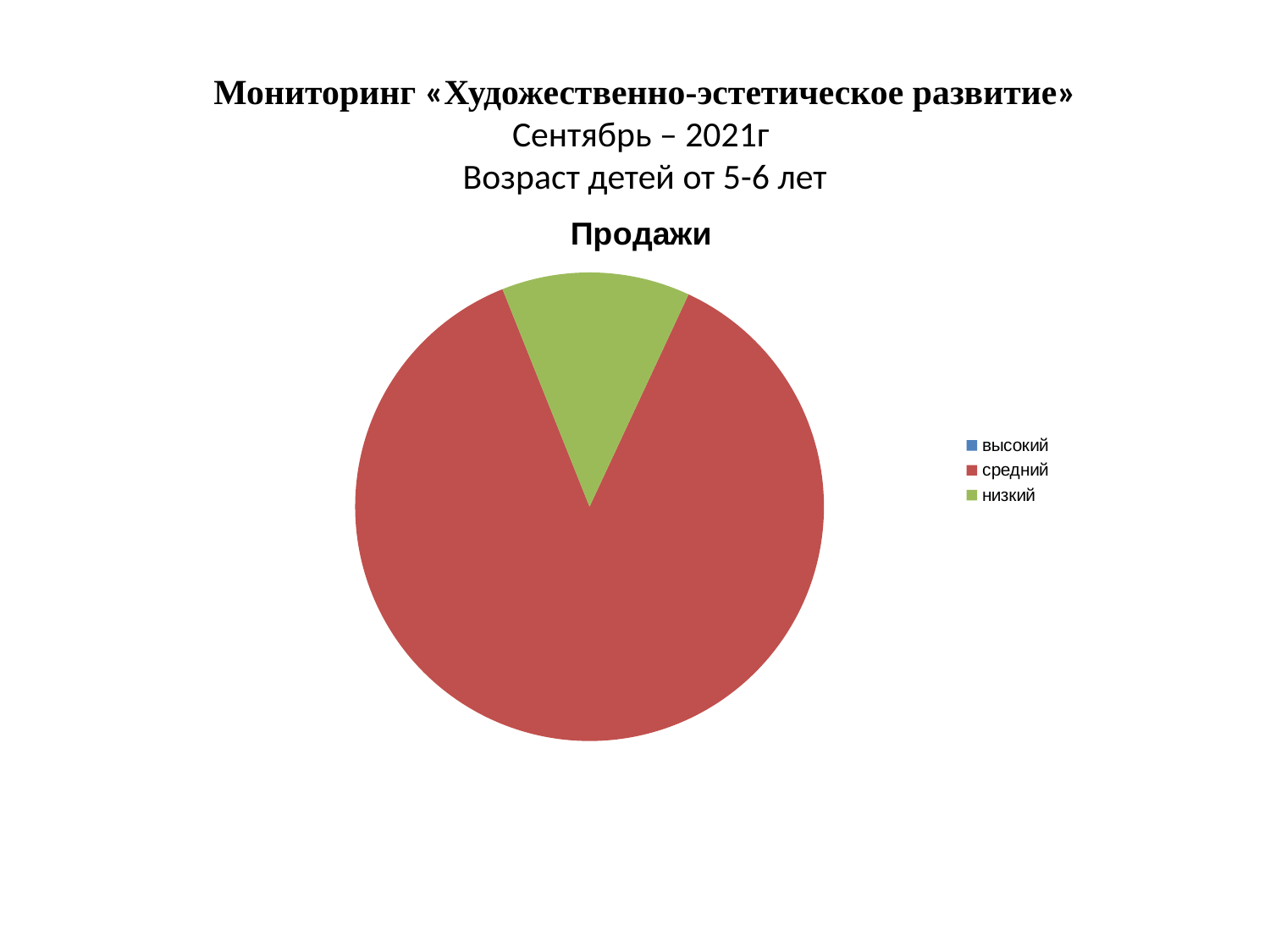
Does the slice for низкий take up more or less than a quarter of the pie? less Does the slice for средний take up more or less than half of the pie? more How many entries does the chart legend list? 3 What kind of chart is shown on the slide? pie chart What is the title of the chart? Продажи Which colour represents the category низкий in the chart? green Which slice is larger, средний or низкий? средний Which category has the largest slice of the pie? средний